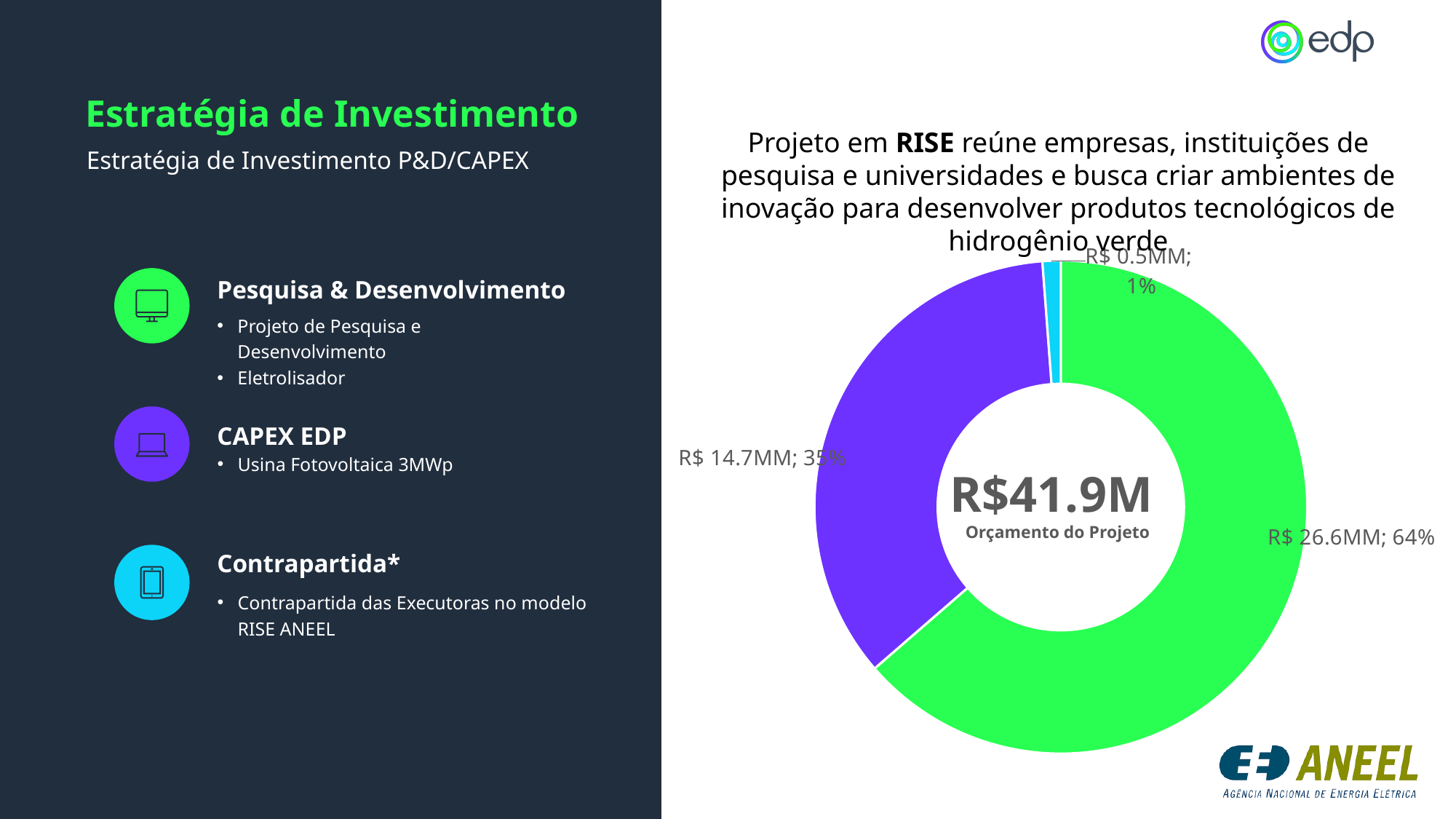
What share of the donut chart does the cyan slice represent? 1% What share of the donut chart does the purple slice represent? 35% How many slices does the donut chart have? 3 What value is labelled on the green slice of the donut chart? R$ 26.6MM What value is labelled on the purple slice of the donut chart? R$ 14.7MM What share of the donut chart does the green slice represent? 64% What kind of chart is shown on the right side of the slide? pie (donut) chart What is the difference between the green slice value and the purple slice value in the donut chart? R$ 11.9MM Which slice of the donut chart is the largest? the green slice (R$ 26.6MM; 64%) What total budget is printed in the centre of the donut chart? R$41.9M Which slice of the donut chart is the smallest? the cyan slice (R$ 0.5MM; 1%) What value is labelled on the cyan slice of the donut chart? R$ 0.5MM